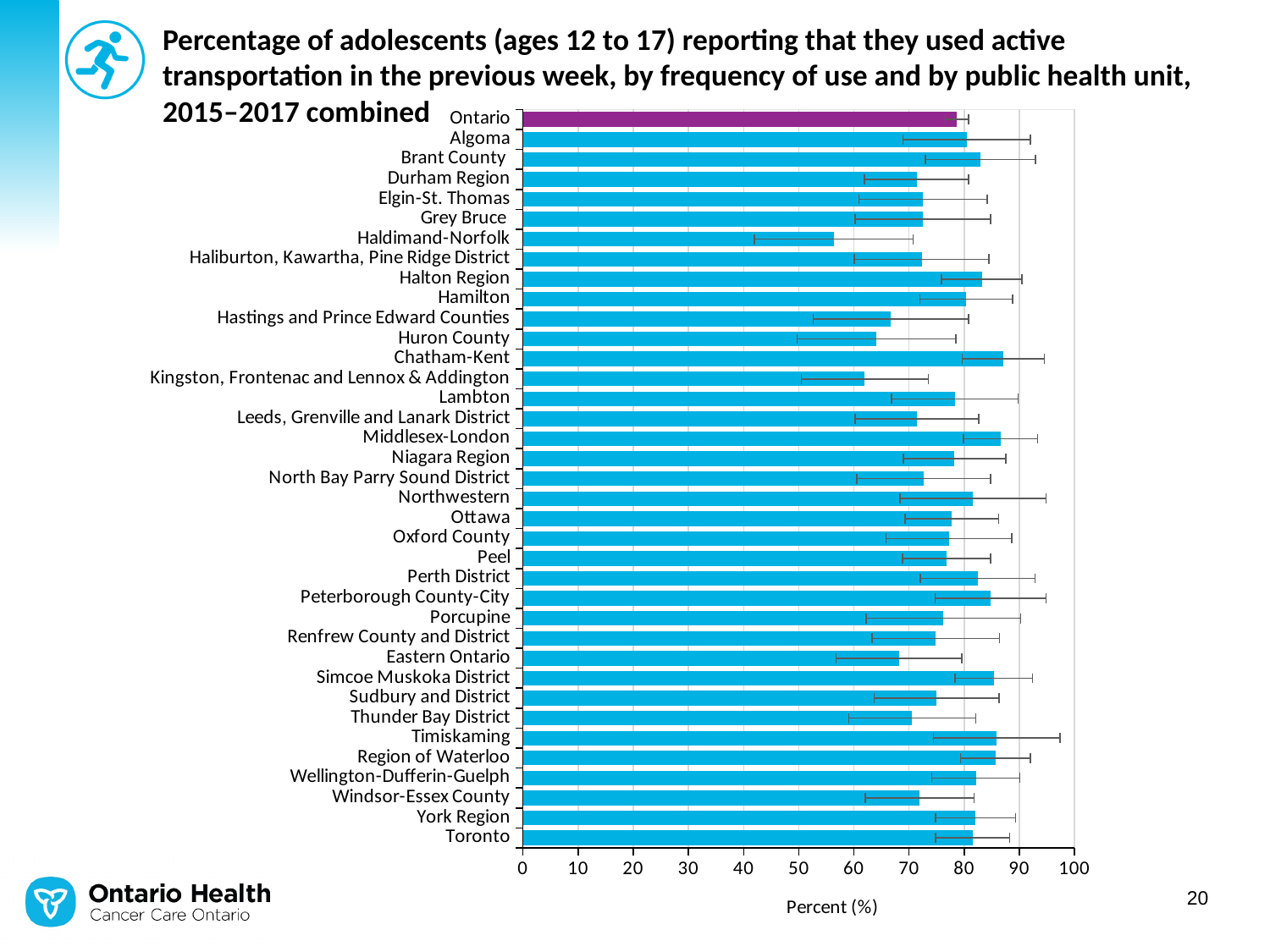
What is the label on the horizontal axis of the chart? Percent (%) Which has a higher value, Haldimand-Norfolk or Chatham-Kent? Chatham-Kent Is the value for Chatham-Kent greater or less than 80? greater How many categories (public health units plus Ontario) are plotted on the chart? 37 Which has a higher value, Huron County or Ontario? Ontario What kind of chart is shown on the slide? bar chart Is the value for Haldimand-Norfolk greater or less than 60? less Is the value for Peterborough County-City greater or less than 80? greater Which public health unit has the lowest percentage of adolescents reporting active transportation? Haldimand-Norfolk